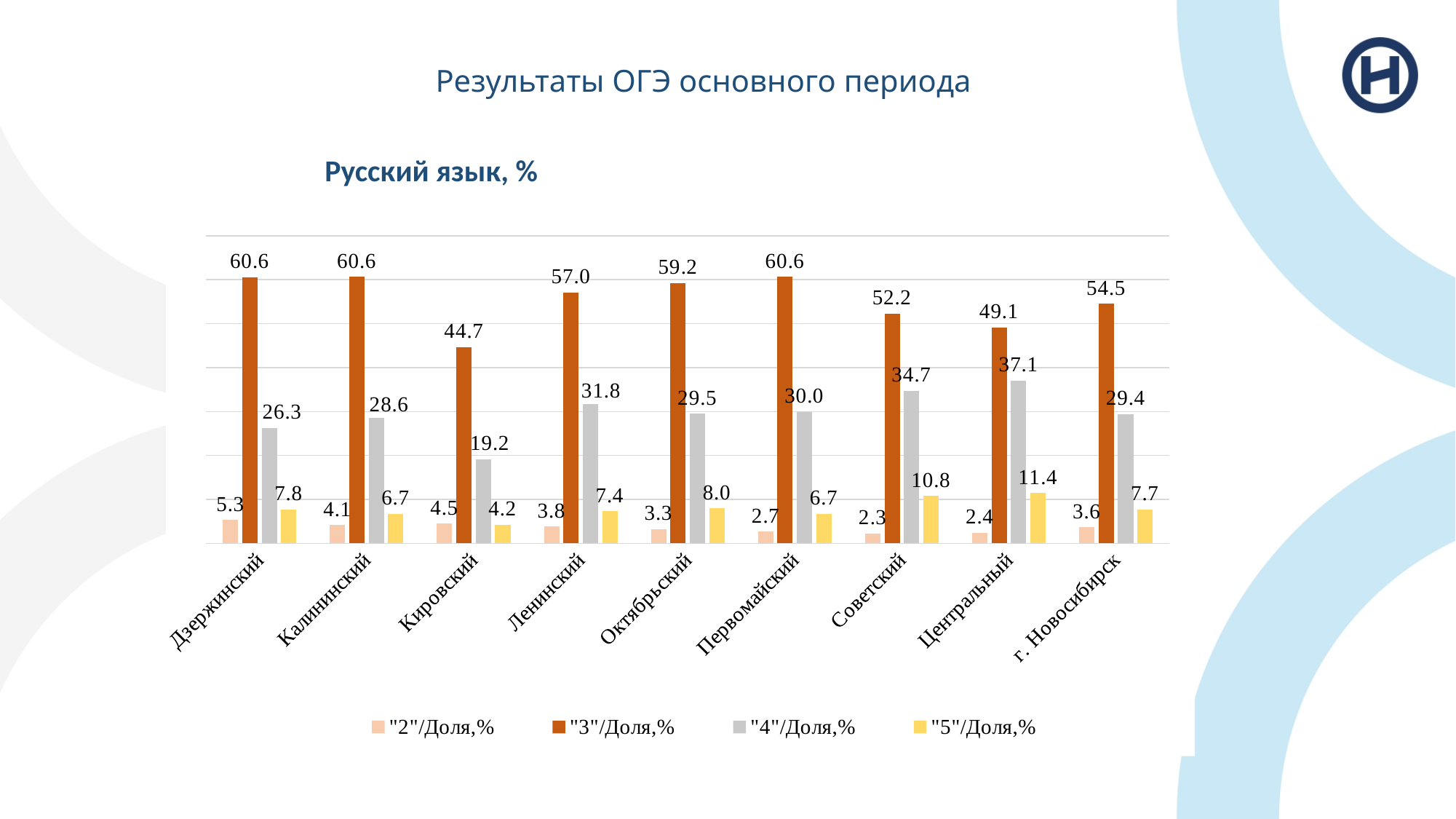
Which category has the lowest value in the "3"/Доля,% series? Кировский Which category has the lowest value in the "5"/Доля,% series? Кировский What is the value of the "5"/Доля,% series for Центральный? 11.4 What type of chart is shown on the slide? bar chart What is the value of the "2"/Доля,% series for г. Новосибирск? 3.6 How many categories are shown on the x axis? 9 What is the value of the "3"/Доля,% series for Кировский? 44.7 Which is larger for Ленинский: the "4"/Доля,% value or the "5"/Доля,% value? "4"/Доля,% What is the difference between the "3"/Доля,% and "4"/Доля,% values for Центральный? 12.0 What is the value of the "4"/Доля,% series for Советский? 34.7 How many series does the legend list? 4 Which category has the highest value in the "4"/Доля,% series? Центральный